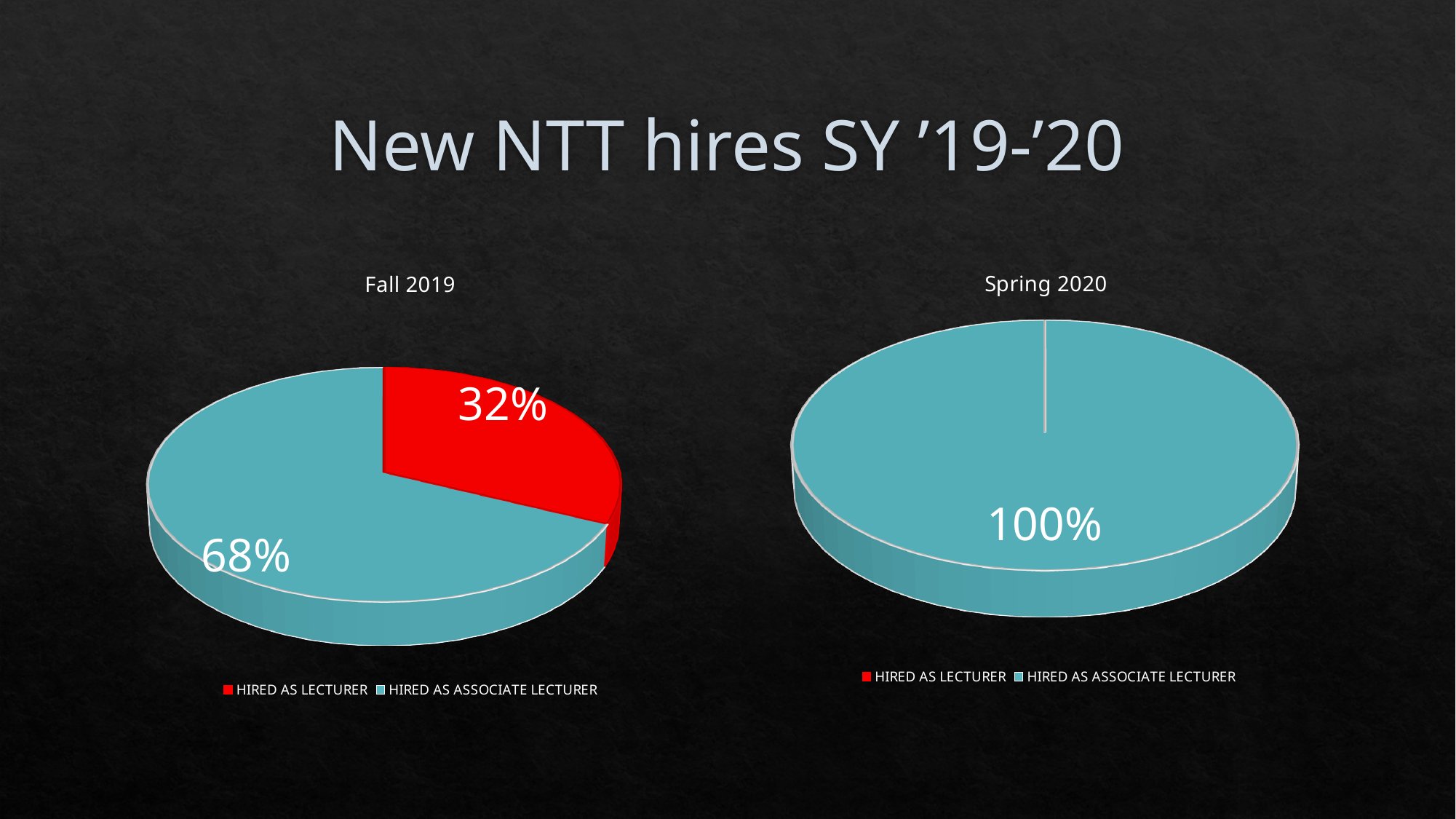
In the Fall 2019 chart, what share of new NTT hires were hired as lecturer? 32% What is the title of the chart on the right side of the slide? Spring 2020 In the Fall 2019 chart, what is the difference in percentage points between the associate lecturer share and the lecturer share? 36 In the Fall 2019 chart, what share of new NTT hires were hired as associate lecturer? 68% How many slices are visible in the Spring 2020 pie chart? 1 What kind of chart is the Fall 2019 chart? Pie chart In the Fall 2019 chart, which category has the smallest slice? HIRED AS LECTURER What colour represents HIRED AS LECTURER in the Fall 2019 chart? Red In the Fall 2019 chart, which is larger: the share hired as lecturer or the share hired as associate lecturer? HIRED AS ASSOCIATE LECTURER How many entries does the legend of the Spring 2020 chart list? 2 In the Spring 2020 chart, what share of new NTT hires were hired as associate lecturer? 100% In the Fall 2019 chart, which category has the largest slice? HIRED AS ASSOCIATE LECTURER